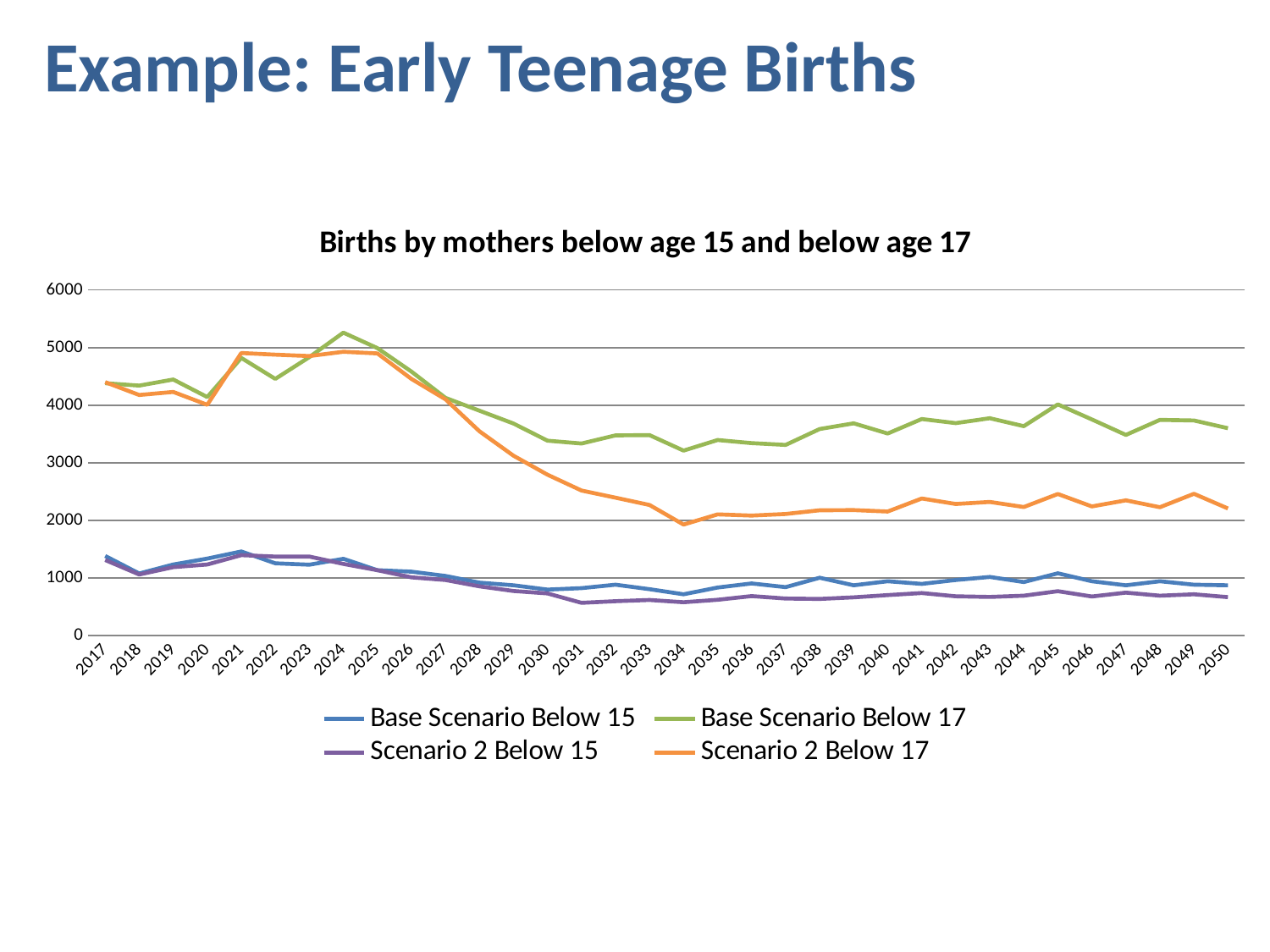
Is the value for Base Scenario Below 17 in 2024 greater or less than 5000? greater What is the title of the chart? Births by mothers below age 15 and below age 17 How many series does the legend list? 4 In which year does the Base Scenario Below 17 line reach its highest value? 2024 How many years are shown along the x axis? 34 In which year does the Scenario 2 Below 17 line reach its lowest value? 2034 Which colour is used for the Scenario 2 Below 17 line? orange Is the value for Scenario 2 Below 17 in 2050 greater or less than 3000? less In 2050, which is higher: Base Scenario Below 17 or Scenario 2 Below 17? Base Scenario Below 17 What kind of chart is shown on the slide? line chart Does the Scenario 2 Below 17 line rise or fall between 2025 and 2034? fall Is the value for Scenario 2 Below 15 in 2031 greater or less than 1000? less